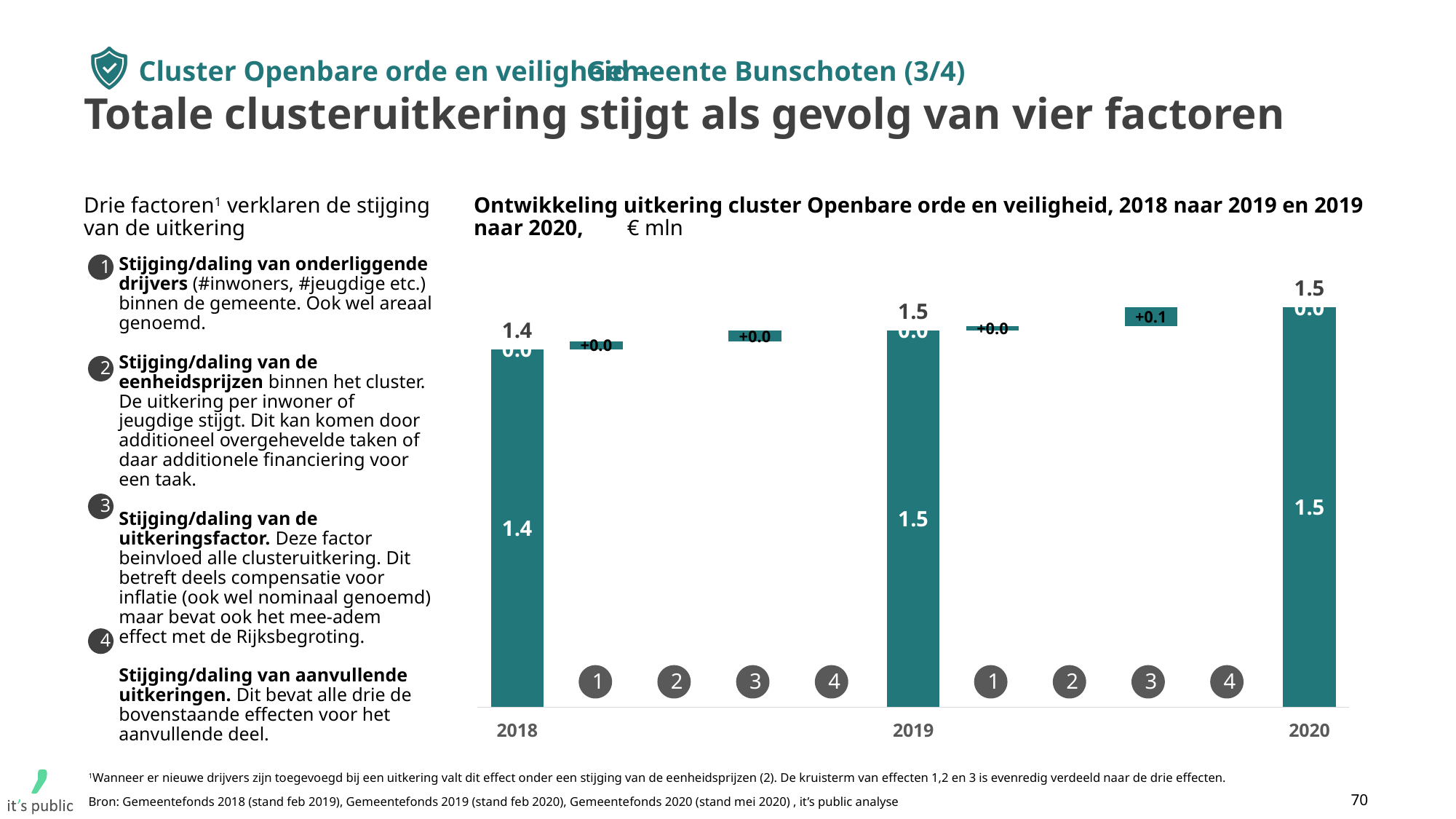
By how much does the total uitkering increase from 2018 to 2019? 0.1 What is the effect of factor 3 between 2019 and 2020 according to the chart? +0.1 What is the total uitkering for 2020 in the chart? 1.5 What kind of chart is shown on the slide? bar chart Which year has a higher total uitkering, 2018 or 2019? 2019 What is the total uitkering for 2018 in the chart? 1.4 Which year has the lowest total uitkering in the chart? 2018 What is the total uitkering for 2019 in the chart? 1.5 What is the effect of factor 3 between 2018 and 2019 according to the chart? +0.0 What is the effect of factor 1 between 2018 and 2019 according to the chart? +0.0 In what unit are the values in the chart expressed? € mln Do the total uitkering values rise or fall from 2018 to 2020? rise